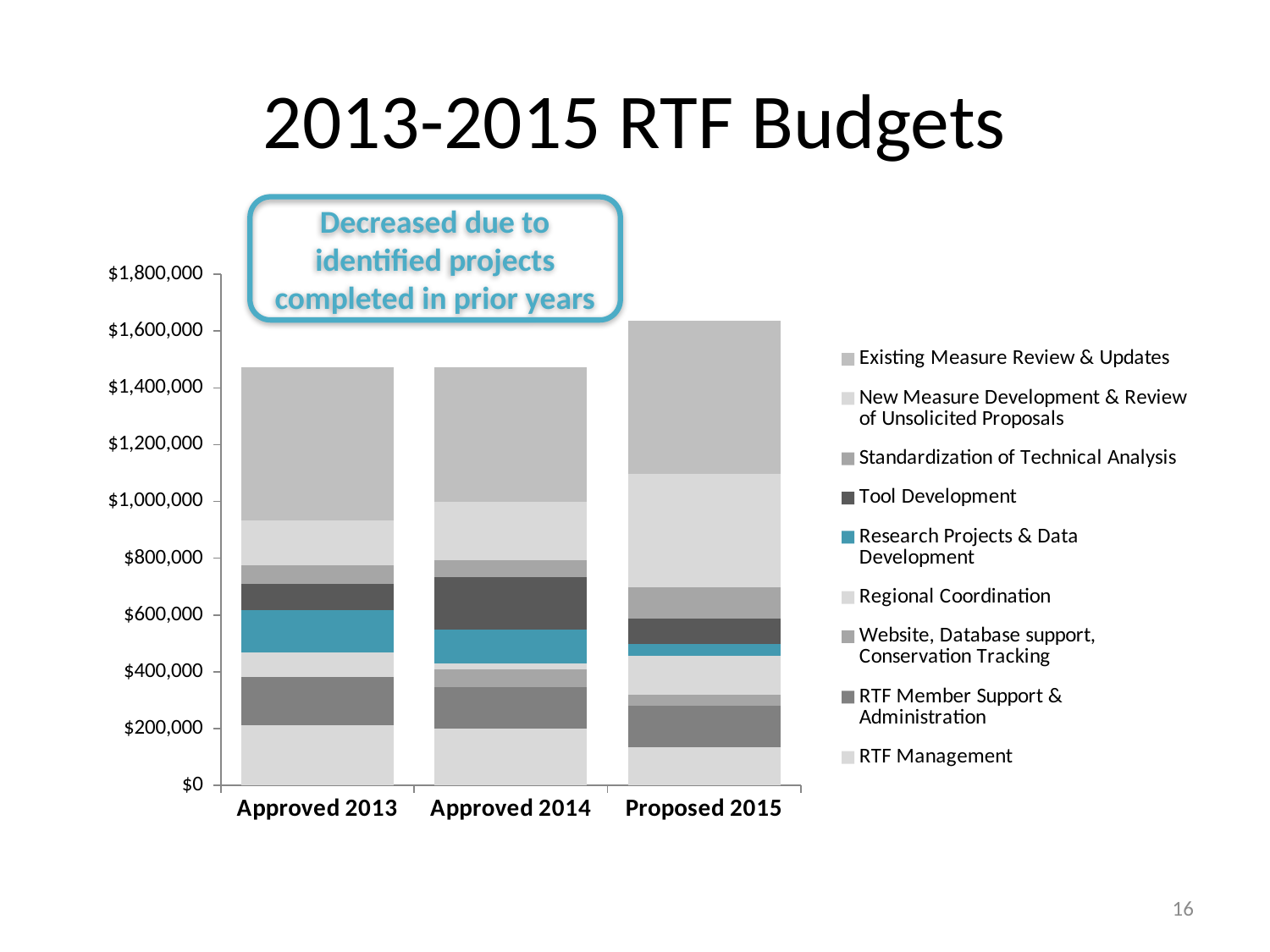
Which series is shown in teal/blue in the chart? Research Projects & Data Development What does the callout box above the chart say? Decreased due to identified projects completed in prior years Which budget year has the highest total bar? Proposed 2015 Is the Research Projects & Data Development segment larger in Approved 2013 or in Proposed 2015? Approved 2013 Is the total for Proposed 2015 greater or less than $1,800,000? less What kind of chart is shown on the slide? Stacked bar chart How many series does the legend list? 9 How many budget years (bars) are shown on the x axis? 3 Is the total for Approved 2013 greater or less than $1,400,000? greater Which series appears at the bottom of each stacked bar? RTF Management Is the total bar for Proposed 2015 larger or smaller than the total bar for Approved 2013? Larger Is the total for Approved 2014 greater or less than $1,600,000? less